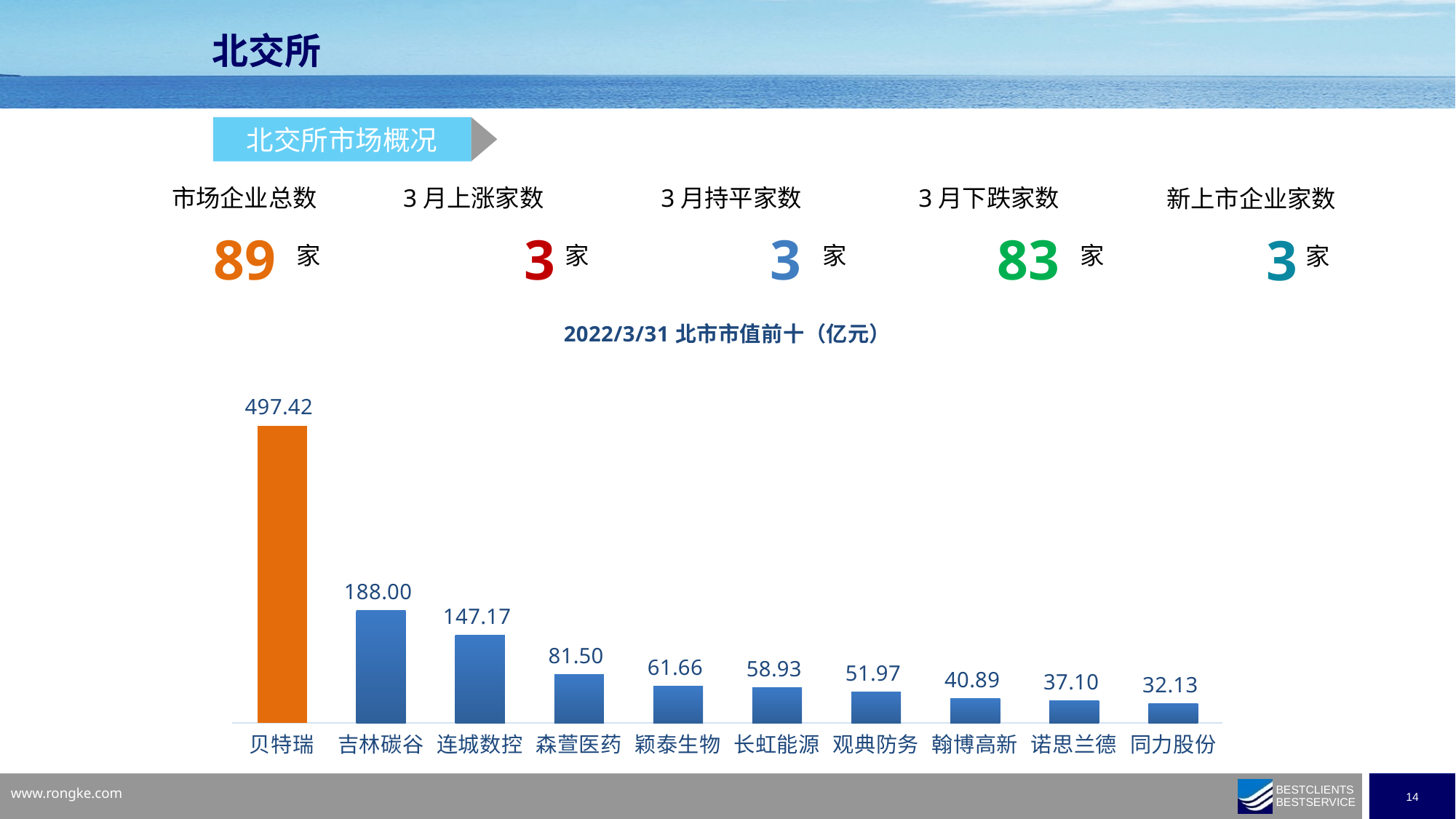
What is the market value shown for 贝特瑞 in the chart? 497.42 What is the title of the chart? 2022/3/31 北市市值前十（亿元） Which has a larger value, 翰博高新 or 诺思兰德? 翰博高新 Do the values rise or fall from left to right along the x axis? Fall What is the difference between the values for 贝特瑞 and 吉林碳谷? 309.42 What is the difference between the values for 森萱医药 and 颖泰生物? 19.84 What is the value shown for 连城数控? 147.17 What type of chart is used to show the top ten market values? Bar chart How many companies are shown in the chart? 10 Which company has the lowest market value in the chart? 同力股份 What is the value shown for 观典防务? 51.97 Which company has the highest market value in the chart? 贝特瑞